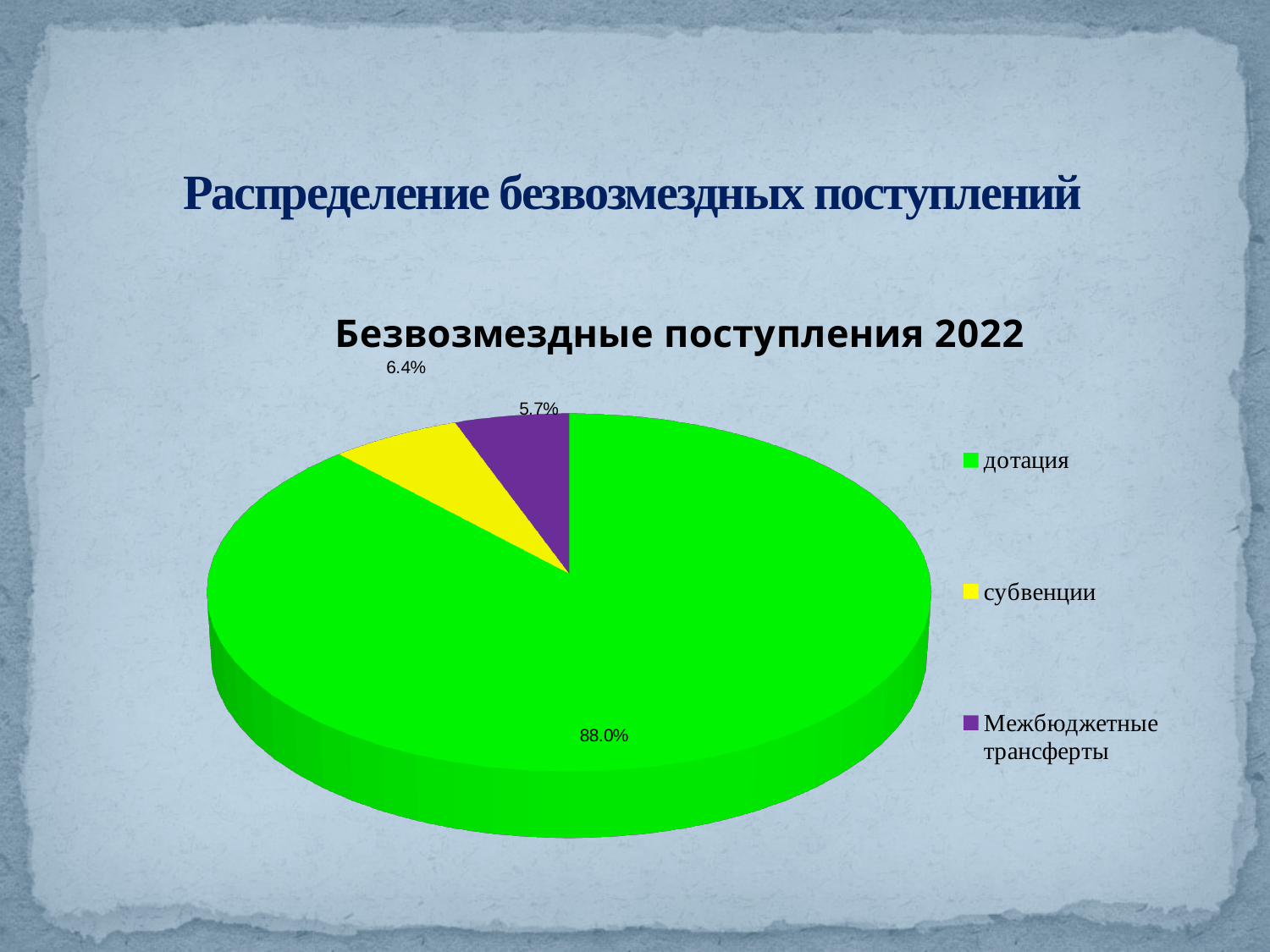
How many slices does the pie chart have? 3 What share of the pie is Межбюджетные трансферты? 5.7% What is the chart's title? Безвозмездные поступления 2022 Which category has the largest share of the pie? дотация Which is larger, the share for субвенции or the share for Межбюджетные трансферты? субвенции What share of the pie is дотация? 88.0% Which category has the smallest share of the pie? Межбюджетные трансферты How many entries does the legend list? 3 What colour is the slice for дотация? green What is the difference between the share for дотация and the share for субвенции? 81.6% What kind of chart is shown on the slide? pie chart What share of the pie is субвенции? 6.4%